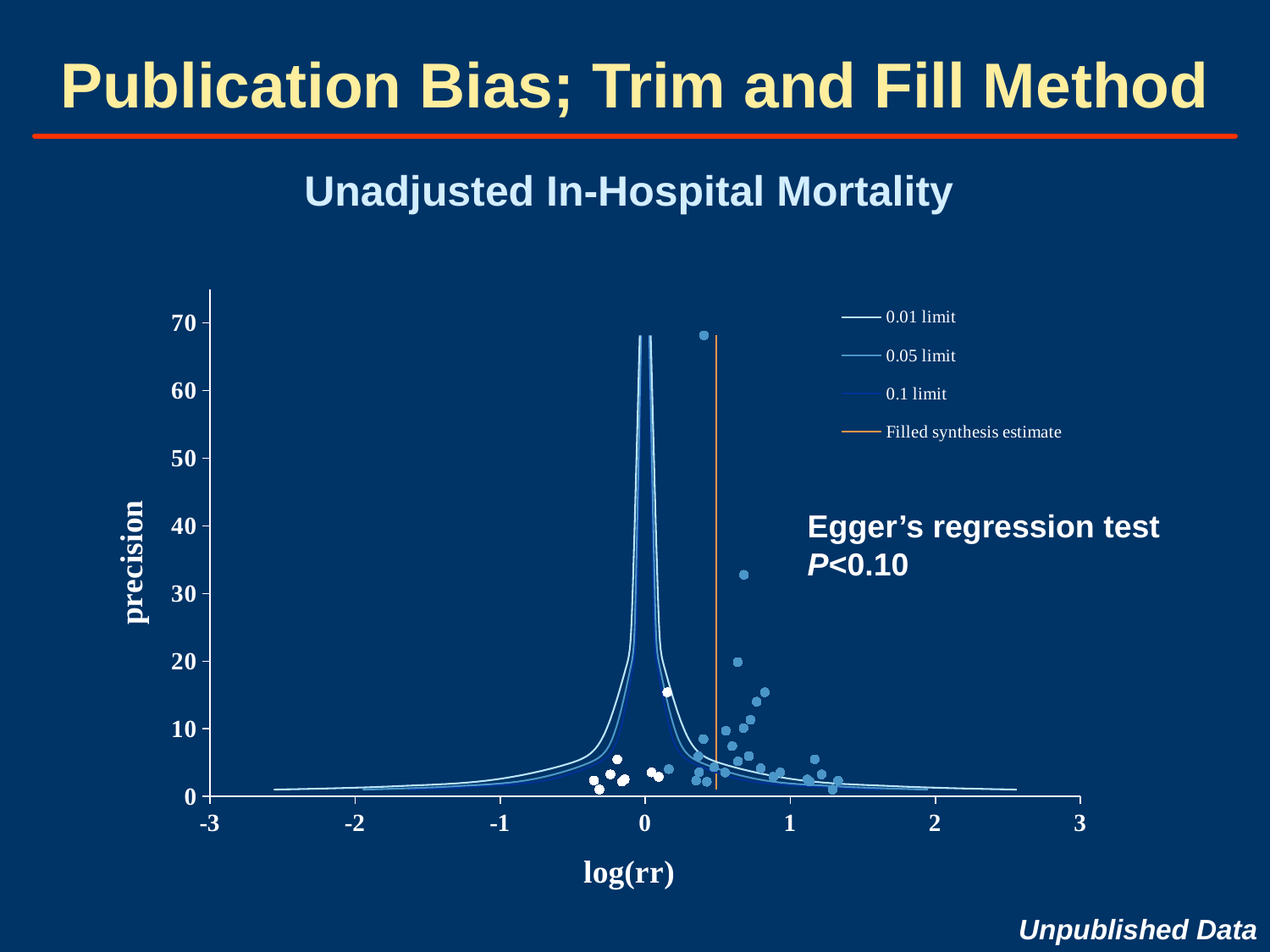
What is the label of the x axis of the chart? log(rr) What kind of chart is shown on the slide? scatter chart Is the log(rr) value of the Filled synthesis estimate line greater or less than 1? less Is the log(rr) value of the Filled synthesis estimate line greater or less than 0? greater What is the lowest tick value shown on the x axis? -3 Is the precision of the second-highest plotted point (near log(rr) of 0.7) greater or less than 20? greater What is the highest tick value shown on the y axis? 70 How many entries does the chart legend list? 4 What is the label of the y axis of the chart? precision